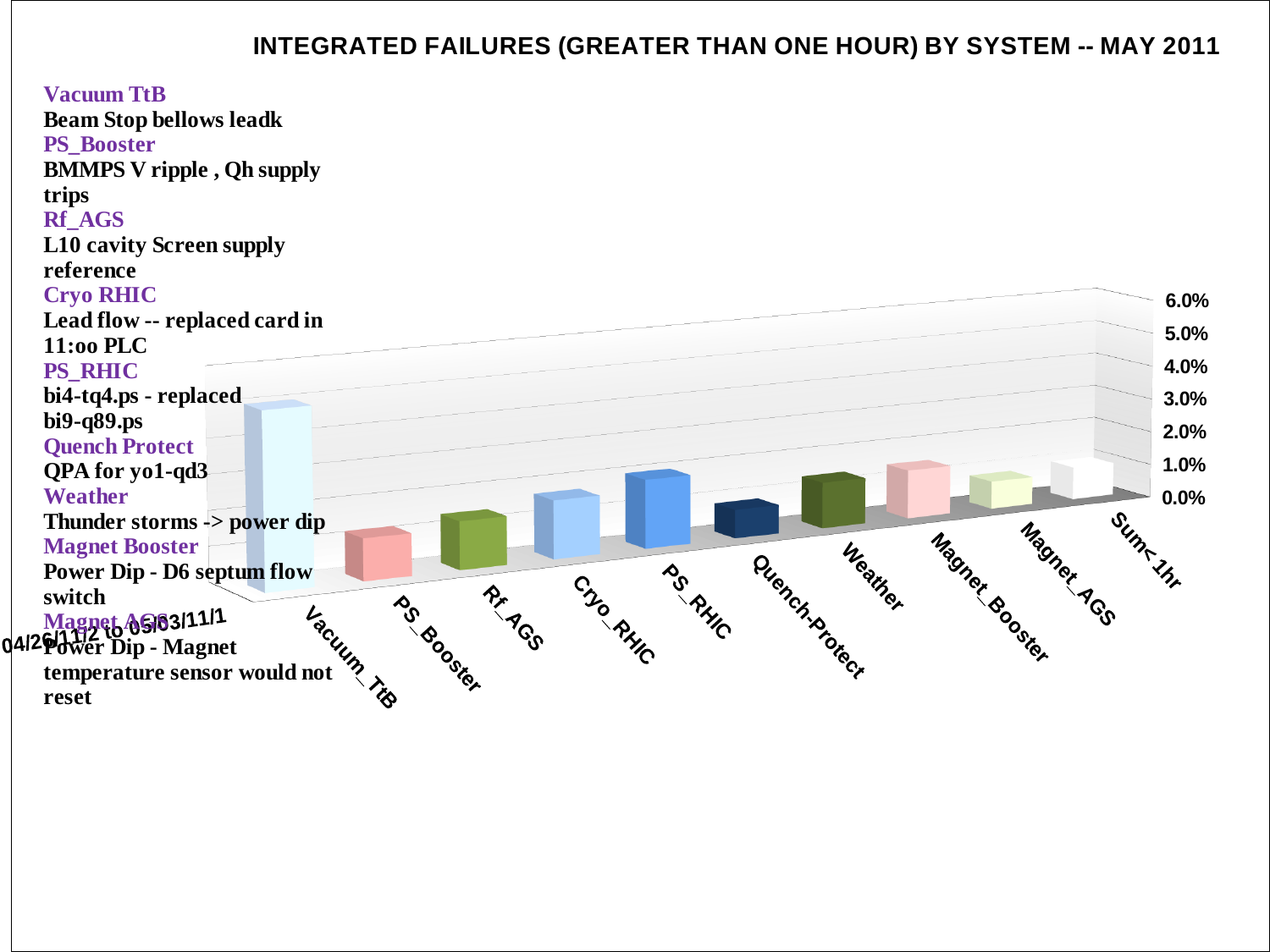
What is the label of the last category on the x axis of the chart? Sum<1hr Which is larger, the value for Vacuum_TtB or the value for Cryo_RHIC? Vacuum_TtB Which system has the highest bar in the chart? Vacuum_TtB What kind of chart is shown on the slide? bar chart Is the value for PS_Booster greater or less than 3.0%? less What is the title of the chart? INTEGRATED FAILURES (GREATER THAN ONE HOUR) BY SYSTEM -- MAY 2011 Which is larger, the value for Cryo_RHIC or the value for PS_RHIC? PS_RHIC What is the highest value shown on the chart's vertical axis? 6.0% Is the value for Vacuum_TtB greater or less than 3.0%? greater How many categories are plotted along the x axis of the chart? 10 Is the value for Cryo_RHIC greater or less than 4.0%? less